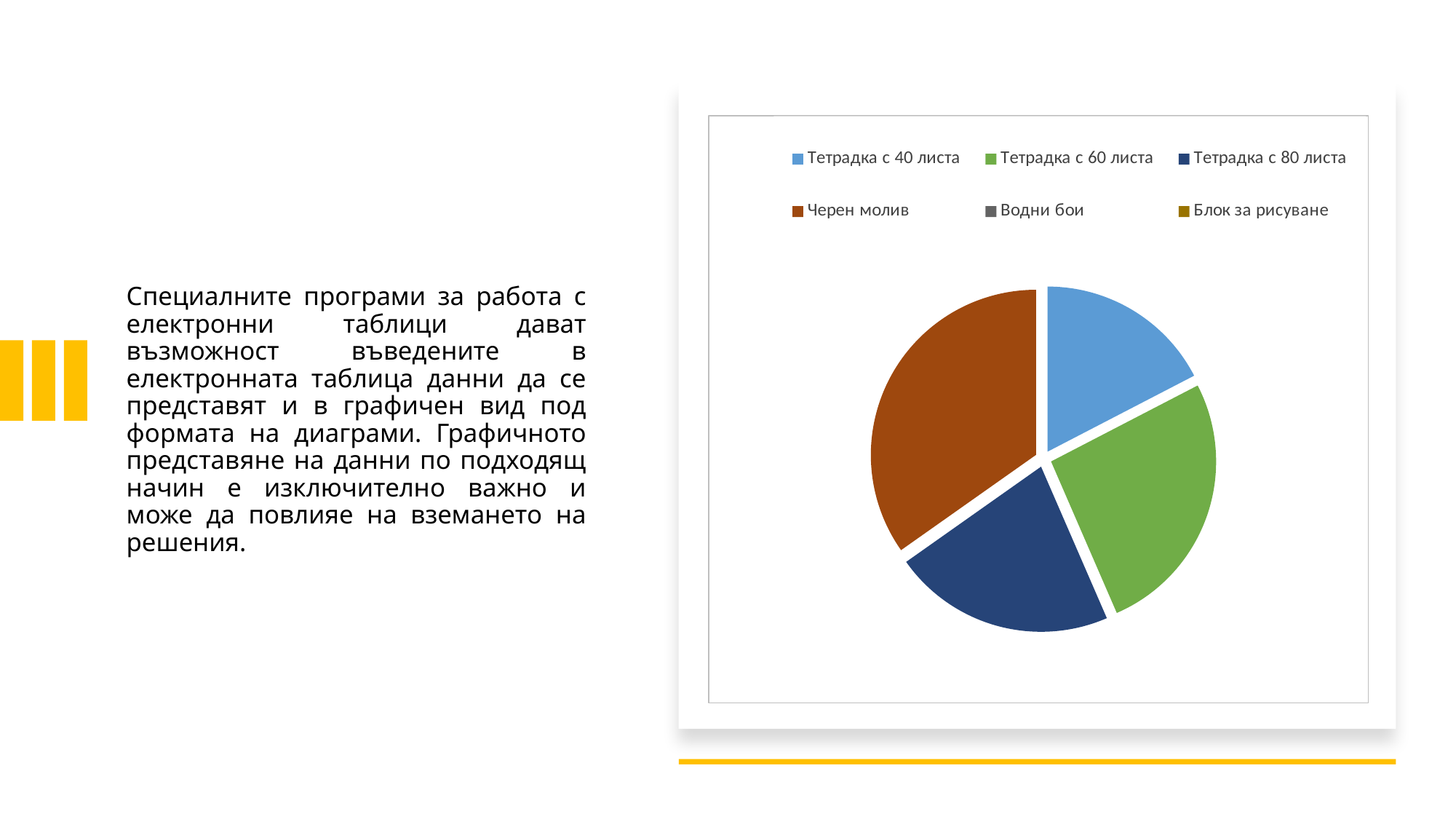
How many slices are visible in the pie chart? 4 Of the four visible slices in the pie chart, which category has the smallest slice? Тетрадка с 40 листа How many entries does the legend of the pie chart list? 6 Which is larger in the pie chart: the slice for Тетрадка с 60 листа or the slice for Тетрадка с 40 листа? Тетрадка с 60 листа What kind of chart is shown on the slide? pie chart What colour is the slice for Черен молив in the pie chart? brown Which is larger in the pie chart: the slice for Черен молив or the slice for Тетрадка с 80 листа? Черен молив Which is larger in the pie chart: the slice for Черен молив or the slice for Тетрадка с 40 листа? Черен молив Which category has the largest slice in the pie chart? Черен молив Which legend entry is shown in green in the pie chart? Тетрадка с 60 листа